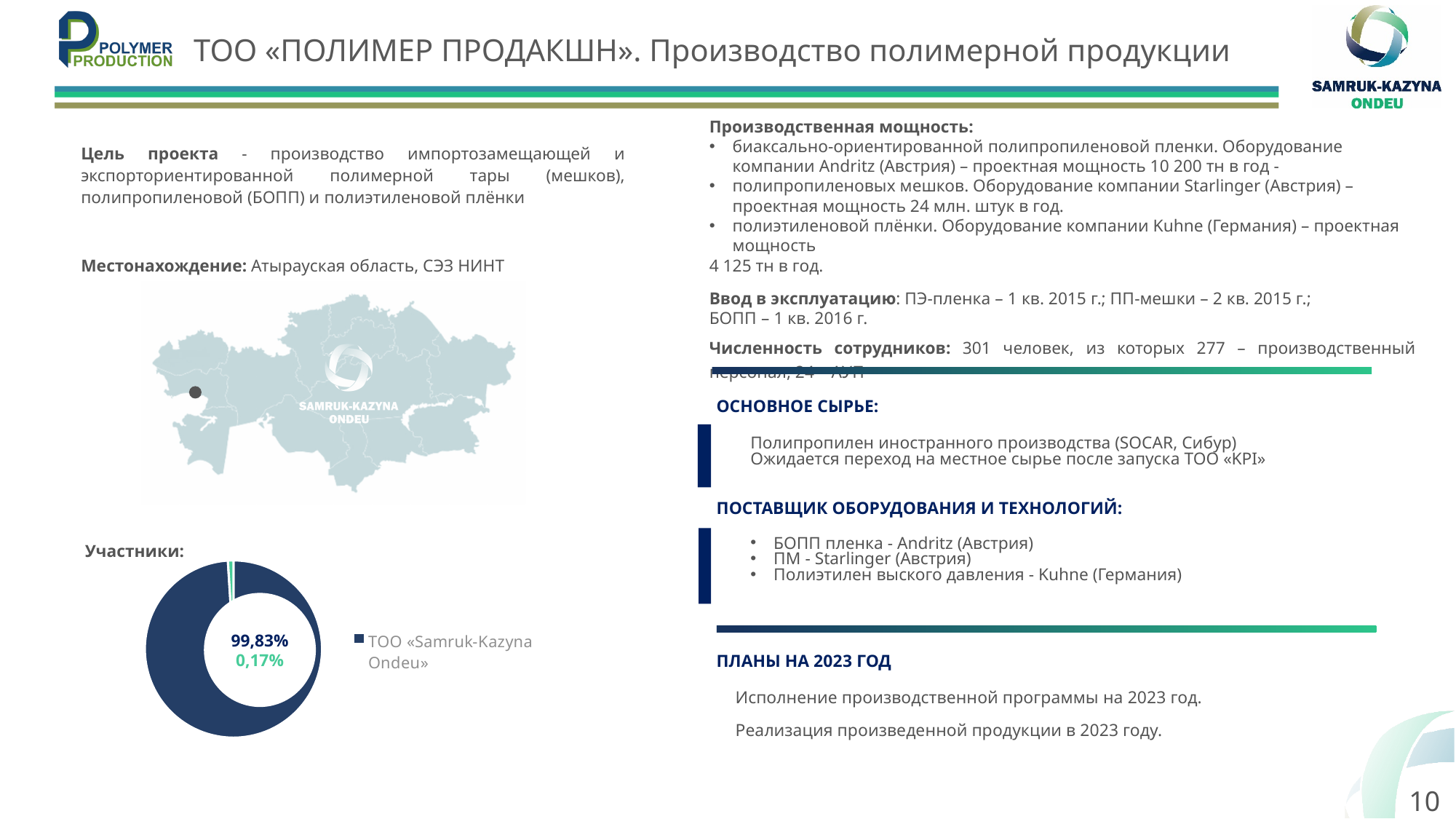
In the "Участники:" chart, what is the value of the smaller slice? 0,17% What kind of chart is shown under "Участники:"? Pie chart (doughnut) What is the heading printed above the pie chart on the slide? Участники: How many data labels are printed on the "Участники:" chart? 2 Which participant holds the largest share in the "Участники:" chart? ТОО «Samruk-Kazyna Ondeu» In the "Участники:" chart, what is the difference between the two printed shares, 99,83% and 0,17%? 99,66% In the "Участники:" chart, what share is shown for ТОО «Samruk-Kazyna Ondeu»? 99,83% In the "Участники:" chart, is the share of ТОО «Samruk-Kazyna Ondeu» greater or less than 50%? greater What colour is the slice for ТОО «Samruk-Kazyna Ondeu» in the "Участники:" chart? Dark blue How many entries does the legend of the "Участники:" chart list? 1 In the "Участники:" chart, what is the value of the larger slice? 99,83% In the "Участники:" chart, which is larger: the 99,83% slice or the 0,17% slice? 99,83%